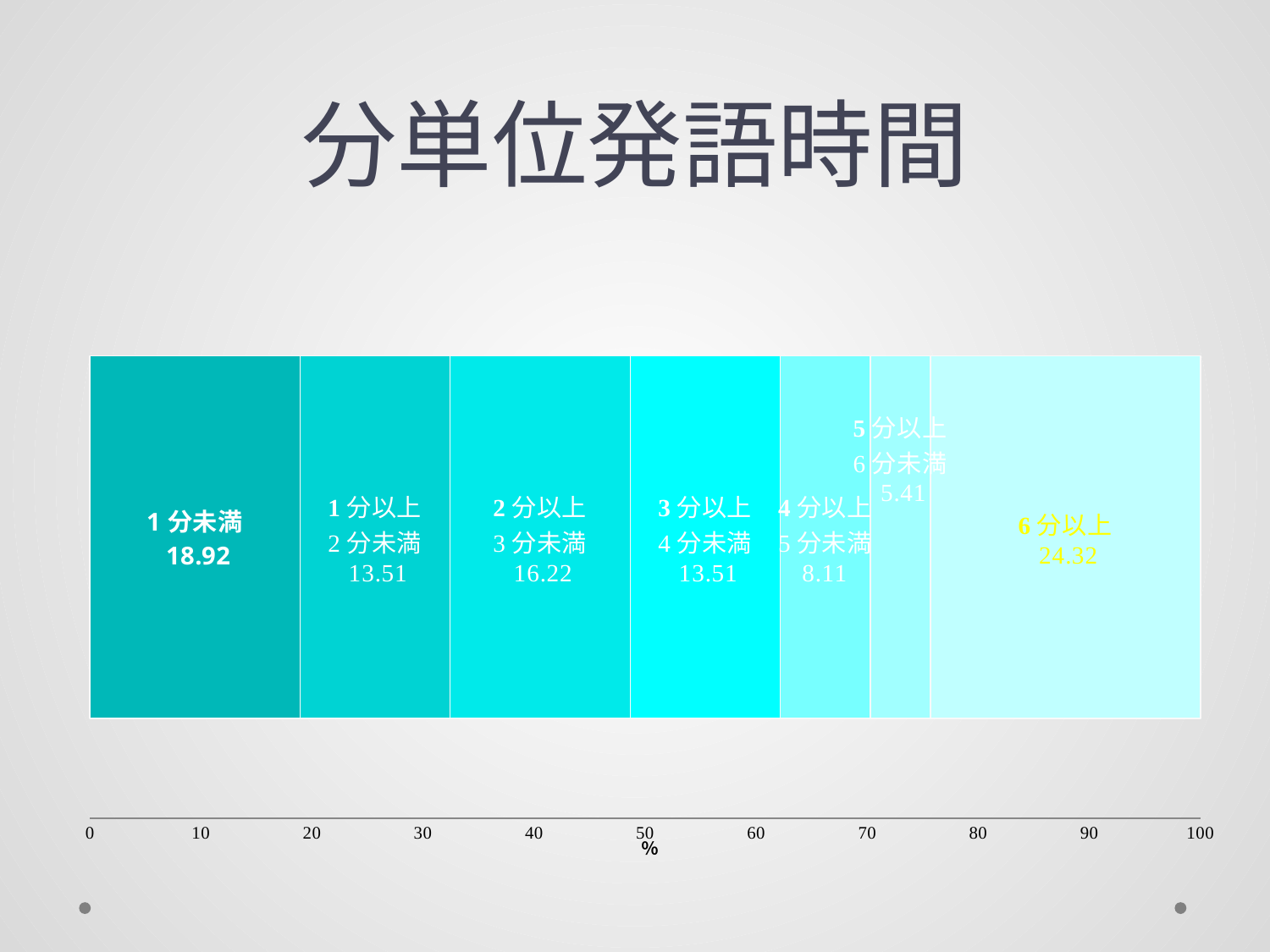
What is the title of the chart? 分単位発語時間 What is the value for the 2分以上3分未満 segment? 16.22 What is the difference between the 6分以上 value and the 1分未満 value? 5.40 How many segments does the bar contain? 7 What kind of chart is shown on the slide? Stacked bar chart What is the total of all segments in the stacked bar? 100 What is the value for the 6分以上 segment? 24.32 Which segment has the lowest value? 5分以上6分未満 Which segment has the highest value? 6分以上 What is the value for the 5分以上6分未満 segment? 5.41 What is the value for the 1分未満 segment? 18.92 Which is larger, the value for 2分以上3分未満 or the value for 4分以上5分未満? 2分以上3分未満